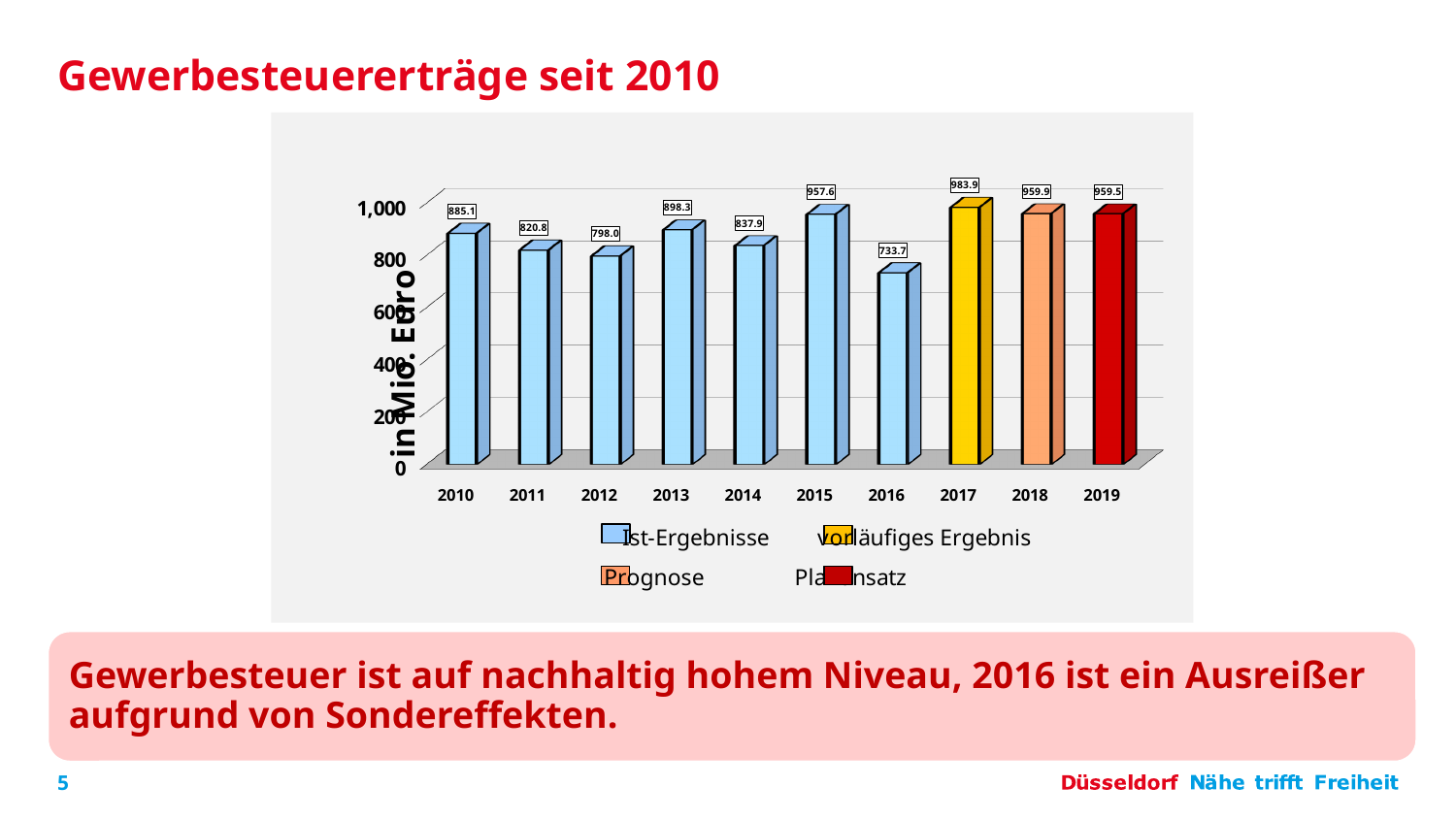
What is the value for 2010? 885.1 What is the difference between the values for 2017 and 2016? 250.2 Is the value for 2016 greater or less than 800? less How many entries does the legend list? 4 How many years are shown on the x axis? 10 What is the value for 2016? 733.7 Which year has the lowest value? 2016 What is the value for 2017? 983.9 Which year has the highest value? 2017 What is the difference between the values for 2015 and 2014? 119.7 Which is larger, the value for 2013 or the value for 2012? 2013 What kind of chart is shown? bar chart